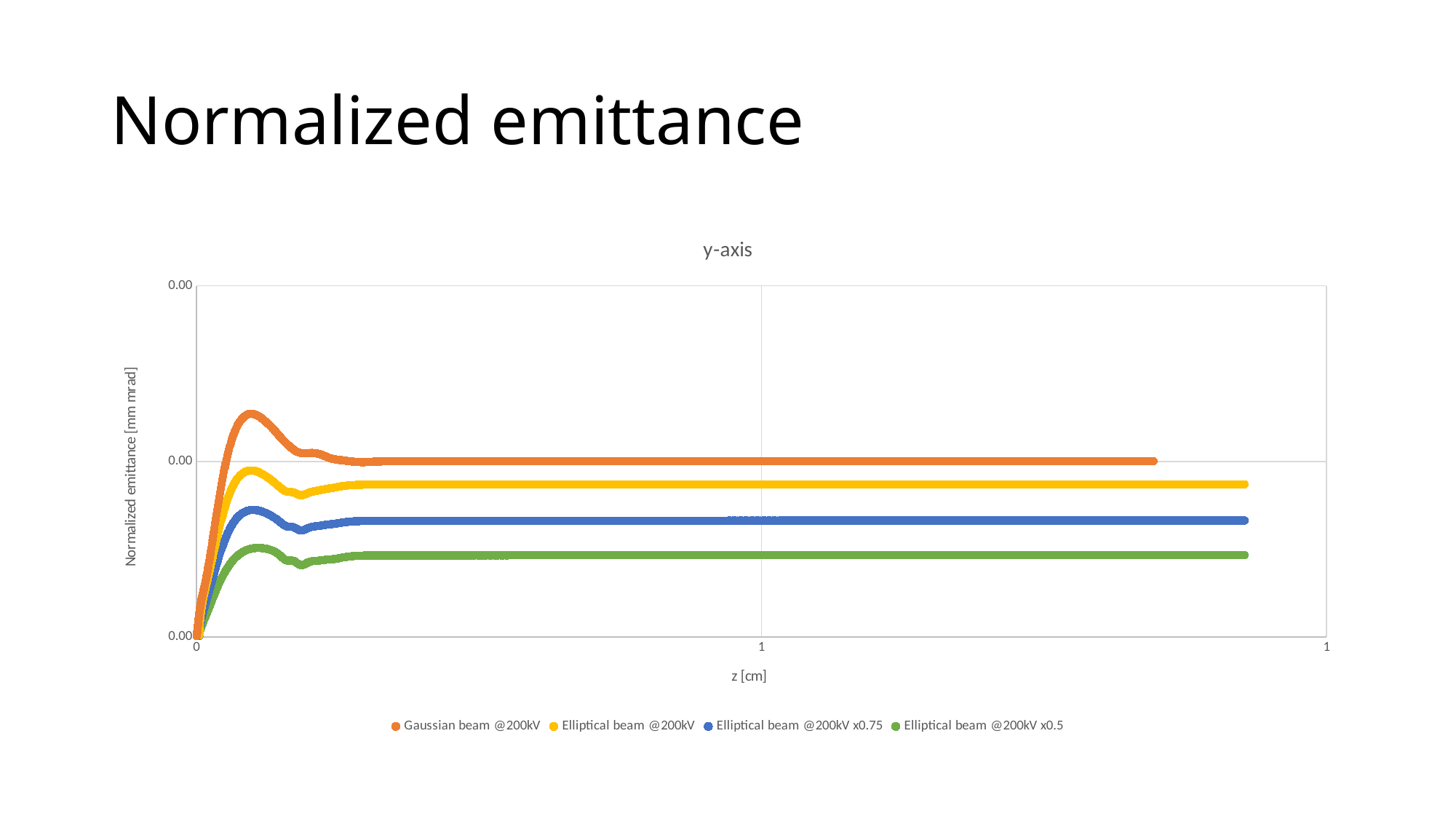
How many series does the legend list? 4 Which series has the larger normalized emittance, Elliptical beam @200kV or Elliptical beam @200kV x0.75? Elliptical beam @200kV Which series has the larger normalized emittance, Elliptical beam @200kV x0.75 or Elliptical beam @200kV x0.5? Elliptical beam @200kV x0.75 Which series has the highest normalized emittance across the plotted range? Gaussian beam @200kV What kind of chart is shown on the slide? line chart Which series has the lowest normalized emittance across the plotted range? Elliptical beam @200kV x0.5 What is the label of the vertical axis? Normalized emittance [mm mrad] How does the normalized emittance of each series behave as z increases? rises sharply, then levels off Which series ends at the smallest z value? Gaussian beam @200kV What is the title of the chart? y-axis